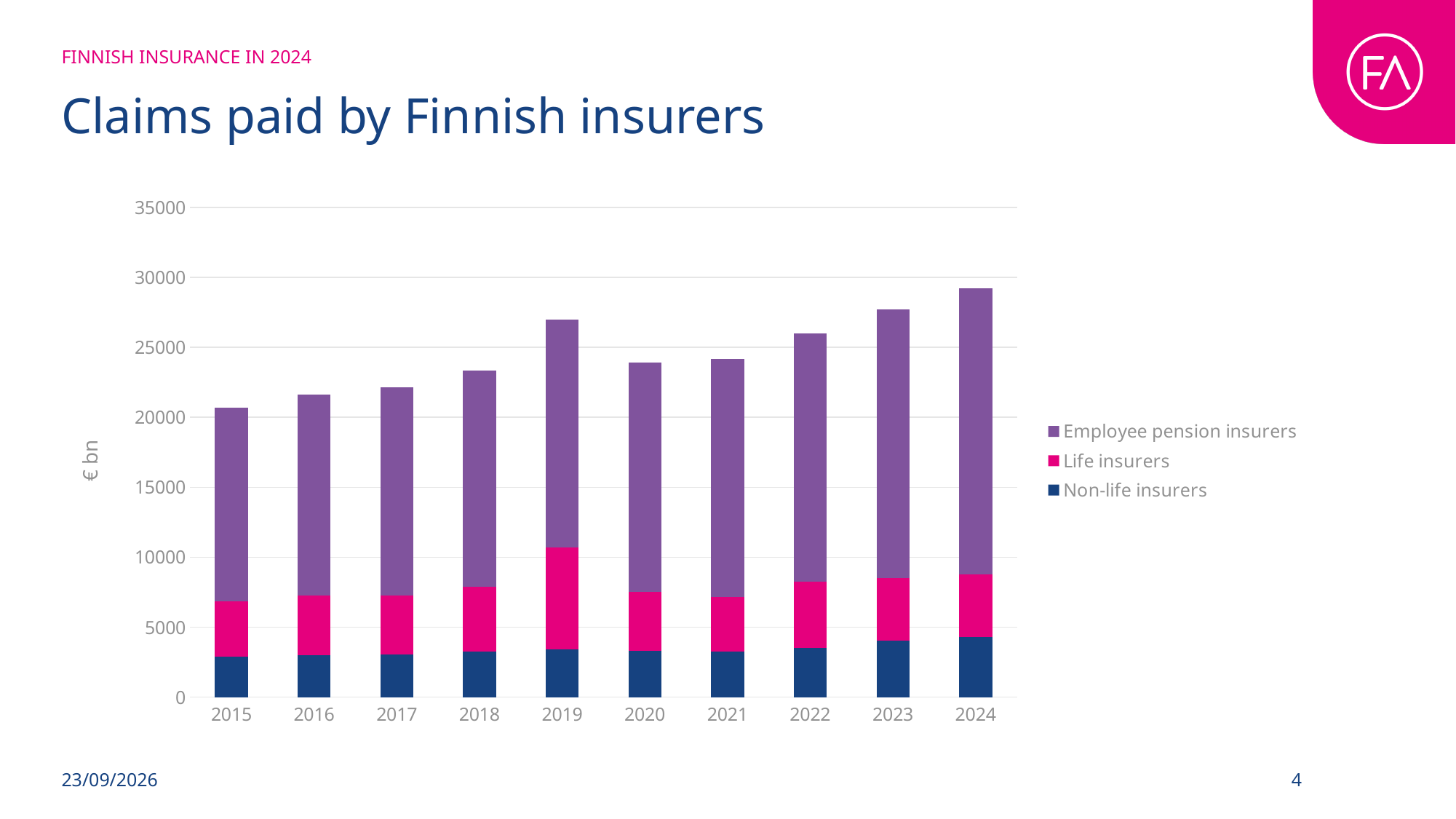
Which series forms the largest segment of each bar? Employee pension insurers Which year has the highest total claims paid? 2024 How many years are shown on the x axis of the chart? 10 What is the title of the chart? Claims paid by Finnish insurers Which year has the lowest total claims paid? 2015 What kind of chart is shown on the slide? Stacked bar chart Is the total value for 2015 greater or less than 25000? less How many series does the legend list? 3 What is the label on the y axis? € bn Is the total value for 2024 greater or less than 25000? greater Which year has a larger total, 2019 or 2020? 2019 Is the total value for 2020 greater or less than 25000? less